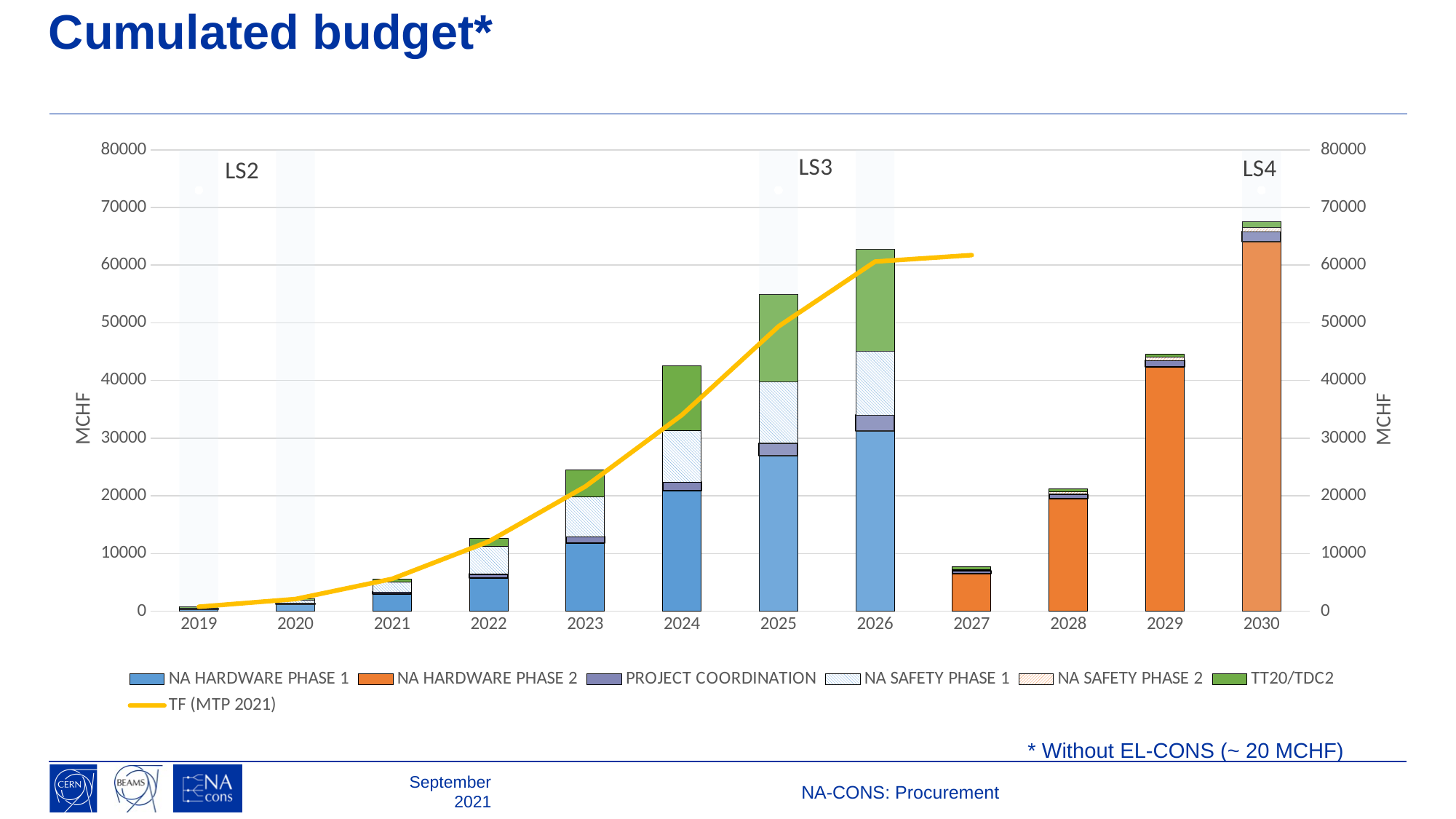
How many years are shown on the x axis of the chart? 12 Which year has the larger stacked bar, 2028 or 2029? 2029 Is the total stacked bar for 2027 greater or less than 10000? less Do the stacked bars rise or fall from 2019 to 2026? rise Is the total stacked bar for 2025 greater or less than 50000? greater What kind of chart is shown on the slide? combination bar and line chart Is the total stacked bar for 2026 greater or less than 60000? greater Which year has the tallest stacked bar? 2030 Which year has the shortest stacked bar? 2019 What is the label on the vertical axis of the chart? MCHF How many series does the legend list? 7